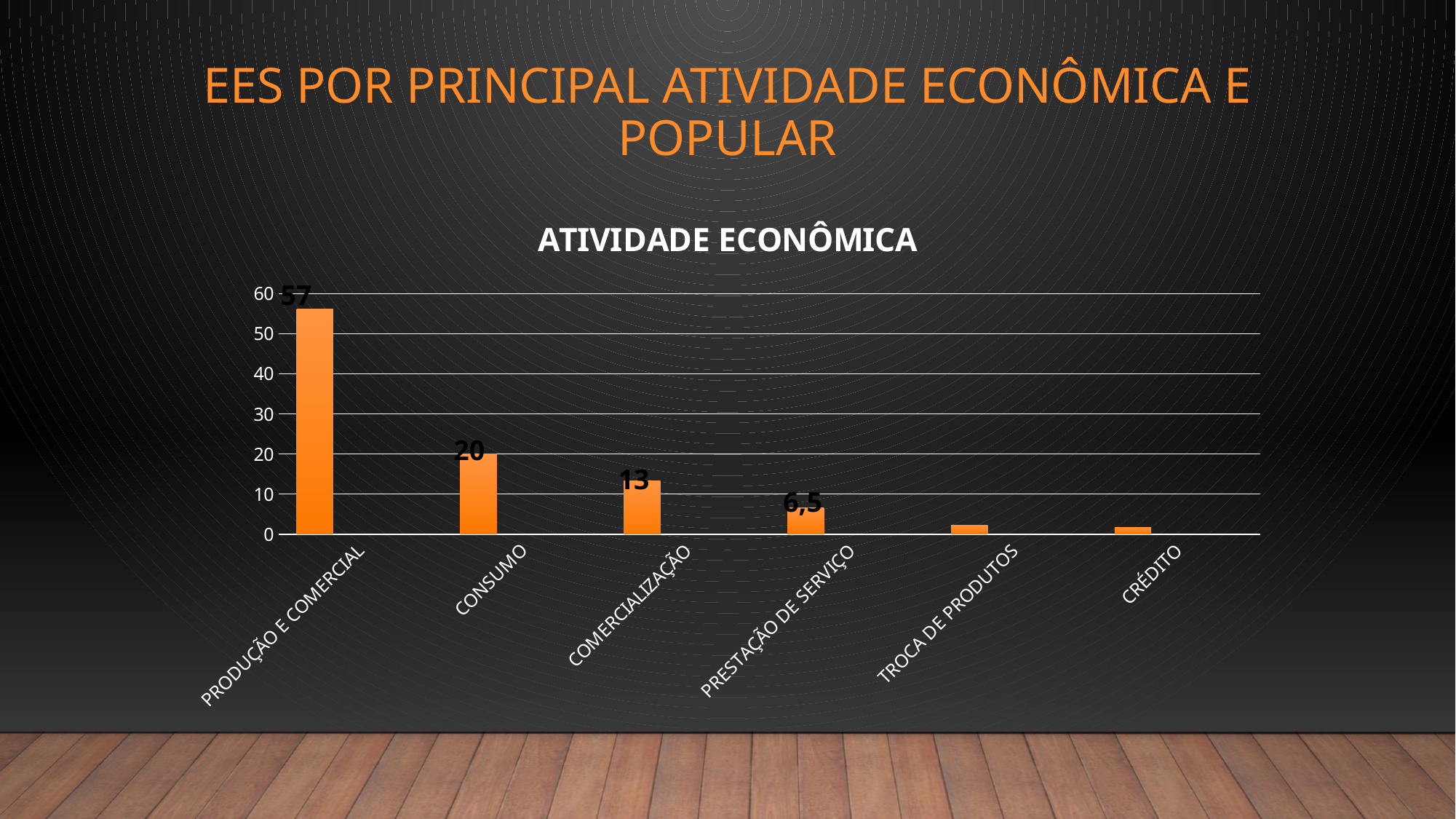
What kind of chart is shown on the slide? bar chart What is the value for PRESTAÇÃO DE SERVIÇO? 6,5 Is the value for TROCA DE PRODUTOS greater or less than 10? less Which is larger, the value for CONSUMO or the value for PRESTAÇÃO DE SERVIÇO? CONSUMO Which category has the highest value? PRODUÇÃO E COMERCIAL What is the value for COMERCIALIZAÇÃO? 13 What is the difference between the values for PRODUÇÃO E COMERCIAL and CONSUMO? 37 What is the value for PRODUÇÃO E COMERCIAL? 57 What is the value for CONSUMO? 20 What is the title of the chart? ATIVIDADE ECONÔMICA How many categories are shown on the x axis? 6 What is the difference between the values for CONSUMO and COMERCIALIZAÇÃO? 7